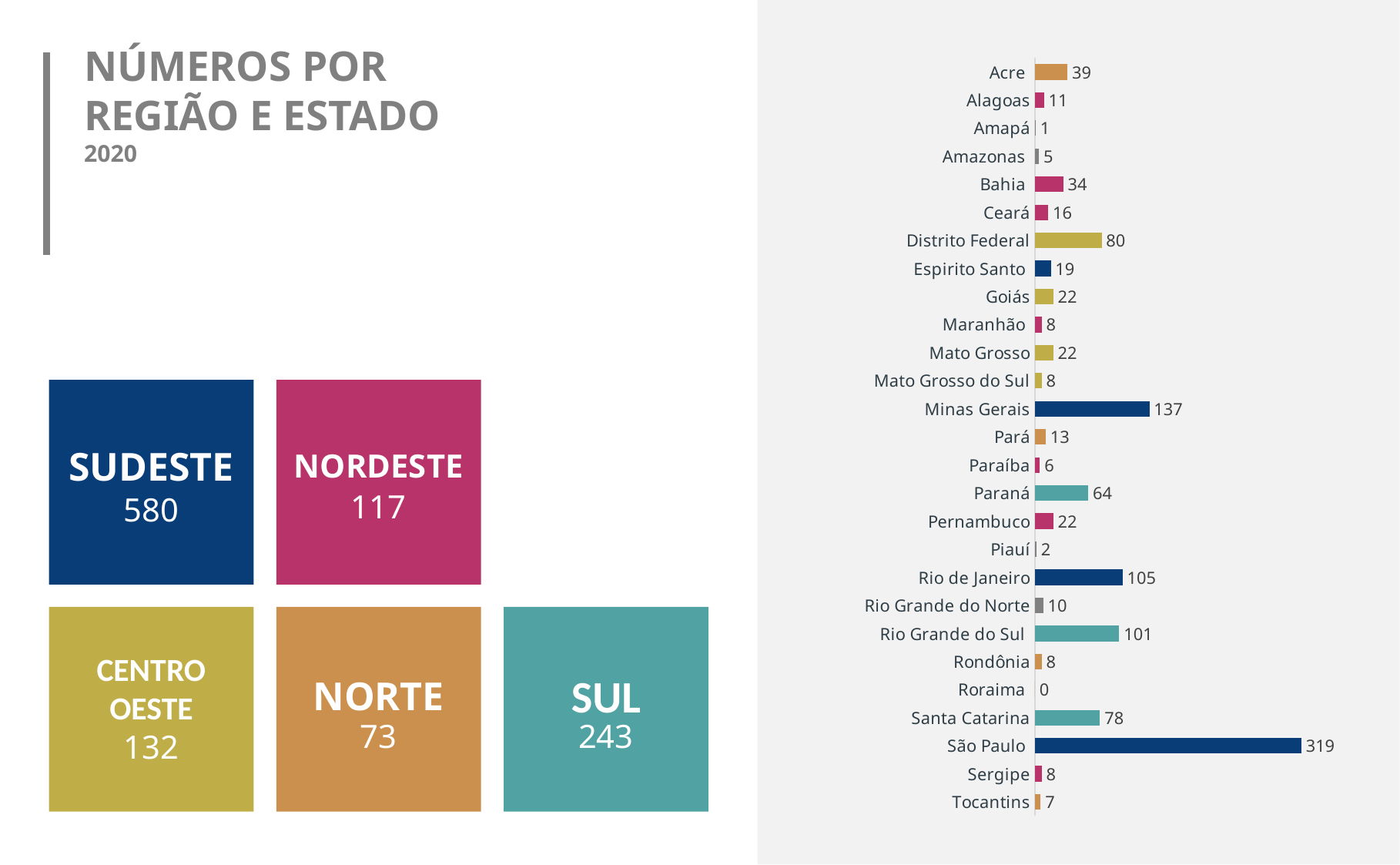
What is the difference between the values for Rio de Janeiro and Rio Grande do Sul? 4 How many states are shown in the chart? 27 Which state has the lowest value in the chart? Roraima What is the value for Distrito Federal? 80 What is the value for Minas Gerais? 137 What is the difference between the values for São Paulo and Minas Gerais? 182 Which state has the highest value in the chart? São Paulo What kind of chart is shown on the slide? Bar chart What is the value for São Paulo? 319 Which has a larger value, Paraná or Santa Catarina? Santa Catarina What is the title of the slide? NÚMEROS POR REGIÃO E ESTADO What is the value for Rio Grande do Sul? 101